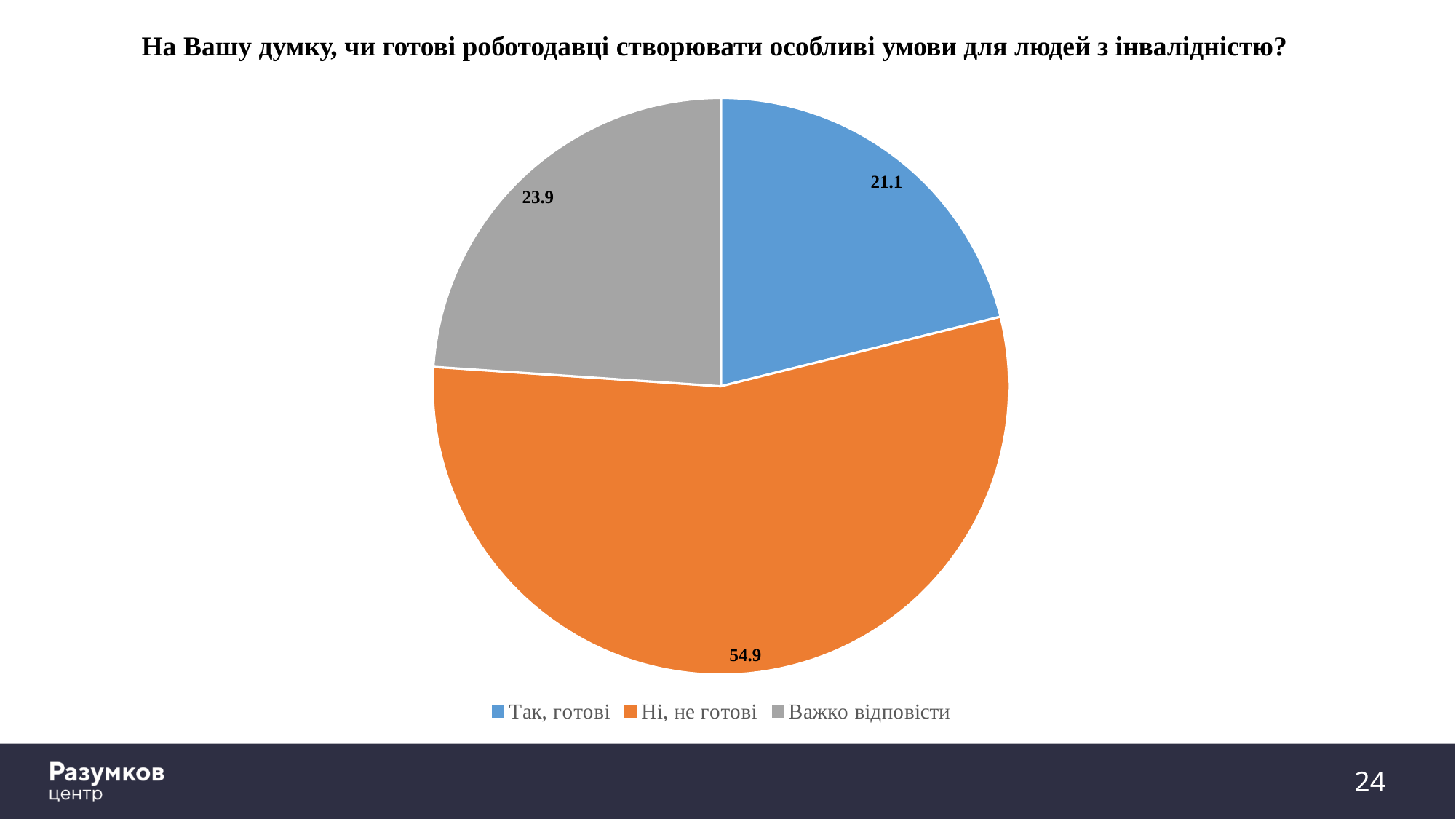
What colour is the slice for "Ні, не готові"? Orange What is the difference between the values for "Ні, не готові" and "Так, готові"? 33.8 Which is larger, the value for "Важко відповісти" or the value for "Так, готові"? Важко відповісти Which slice has the largest value? Ні, не готові What value is shown for the slice "Так, готові"? 21.1 Which slice has the smallest value? Так, готові How many entries does the legend list? 3 What kind of chart is shown on the slide? Pie chart What value is shown for the slice "Важко відповісти"? 23.9 What value is shown for the slice "Ні, не готові"? 54.9 What is the difference between the values for "Важко відповісти" and "Так, готові"? 2.8 How many slices does the pie chart have? 3